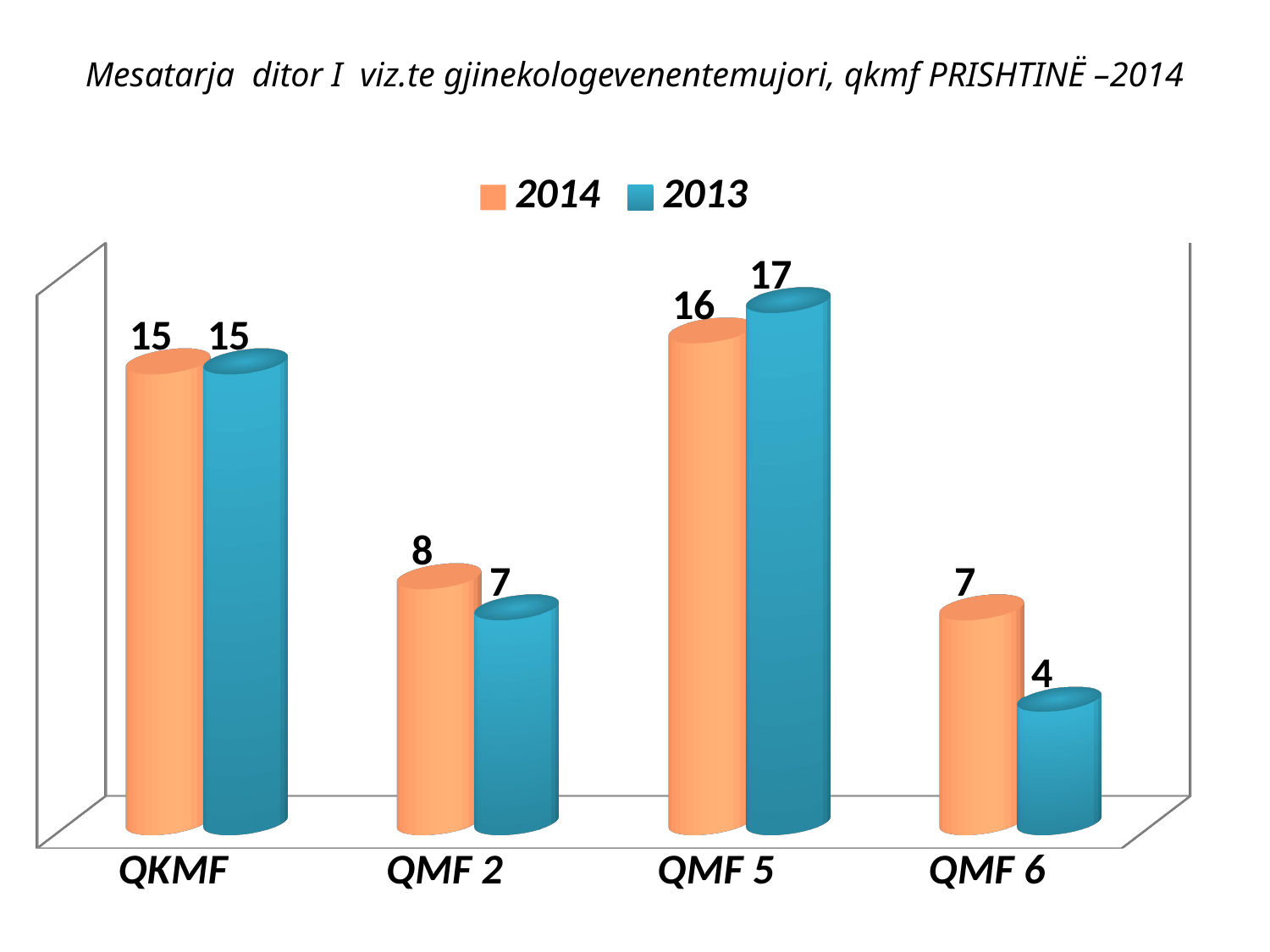
What is the 2013 value for QKMF? 15 How many series does the legend list? 2 Which colour represents the 2013 series in the legend? Blue Which category has the lowest 2014 value? QMF 6 What is the 2013 value for QMF 6? 4 What is the 2014 value for QMF 5? 16 What is the difference between the 2014 and 2013 values for QMF 6? 3 How many categories are shown on the x axis? 4 Which is larger for QMF 5, the 2014 value or the 2013 value? 2013 What is the 2014 value for QMF 2? 8 Which category has the highest 2013 value? QMF 5 What kind of chart is shown on the slide? Bar chart